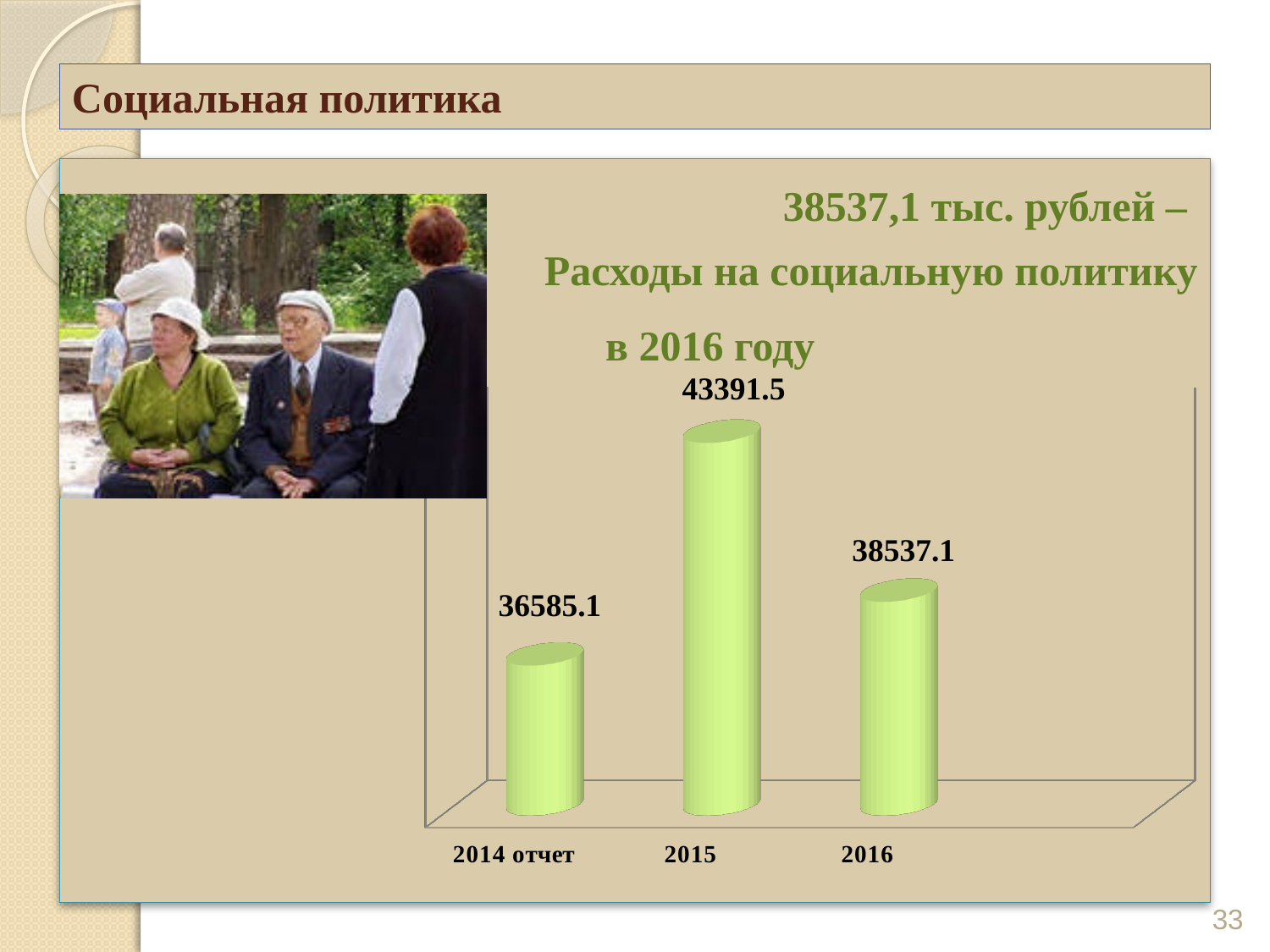
What is the difference between the values for 2016 and 2014 отчет? 1952.0 What colour are the bars in the chart? light green Which category has the lowest value? 2014 отчет What is the value shown for 2015? 43391.5 What kind of chart is shown on the slide? bar chart What is the value shown for 2014 отчет? 36585.1 Which year has the highest value? 2015 How many bars are shown in the chart? 3 Does the value rise or fall from 2015 to 2016? fall What is the value shown for 2016? 38537.1 What is the difference between the values for 2015 and 2016? 4854.4 Which is larger, the value for 2015 or the value for 2016? 2015